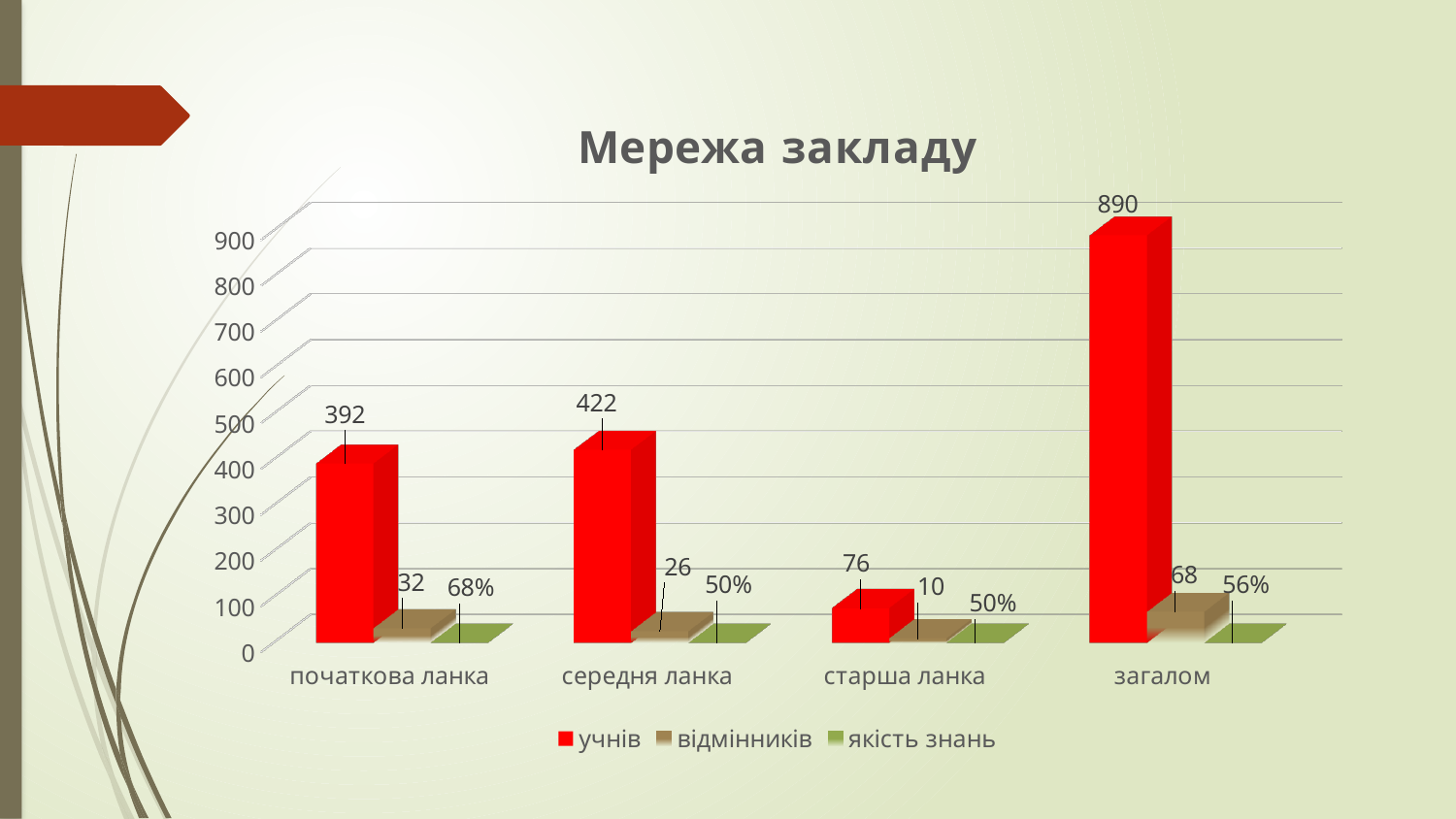
Which category has the highest value for учнів? загалом How many categories are shown on the x axis? 4 Which category has the lowest value for відмінників? старша ланка What is the title of the chart? Мережа закладу What is the value of якість знань for початкова ланка? 68% What is the difference between the учнів values for середня ланка and початкова ланка? 30 Is the value of учнів for старша ланка greater or less than 100? less What is the value of учнів for середня ланка? 422 What is the value of відмінників for загалом? 68 What type of chart is shown on the slide? bar chart Which is larger, the відмінників value for початкова ланка or for середня ланка? початкова ланка How many series does the legend list? 3